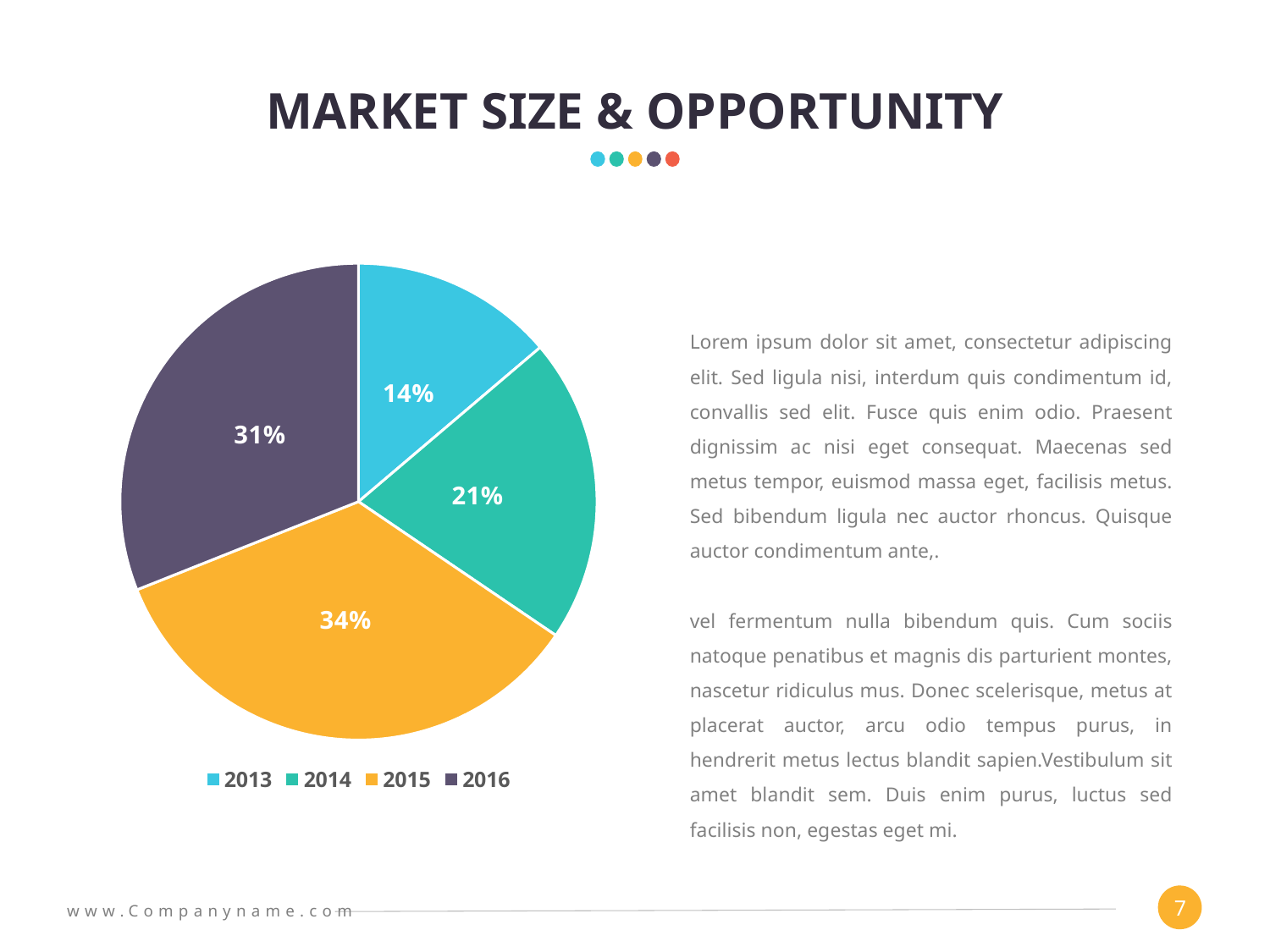
What share of the pie does 2015 represent? 34% Which year has the smallest slice of the pie? 2013 What share of the pie does 2013 represent? 14% What type of chart is shown on the slide? pie chart What share of the pie does 2014 represent? 21% What colour is the slice for 2015? orange What is the difference in percentage points between the 2015 and 2013 slices? 20 Which slice is larger, 2014 or 2016? 2016 What share of the pie does 2016 represent? 31% Which year has the largest slice of the pie? 2015 How many entries does the legend list? 4 How many slices does the pie chart have? 4